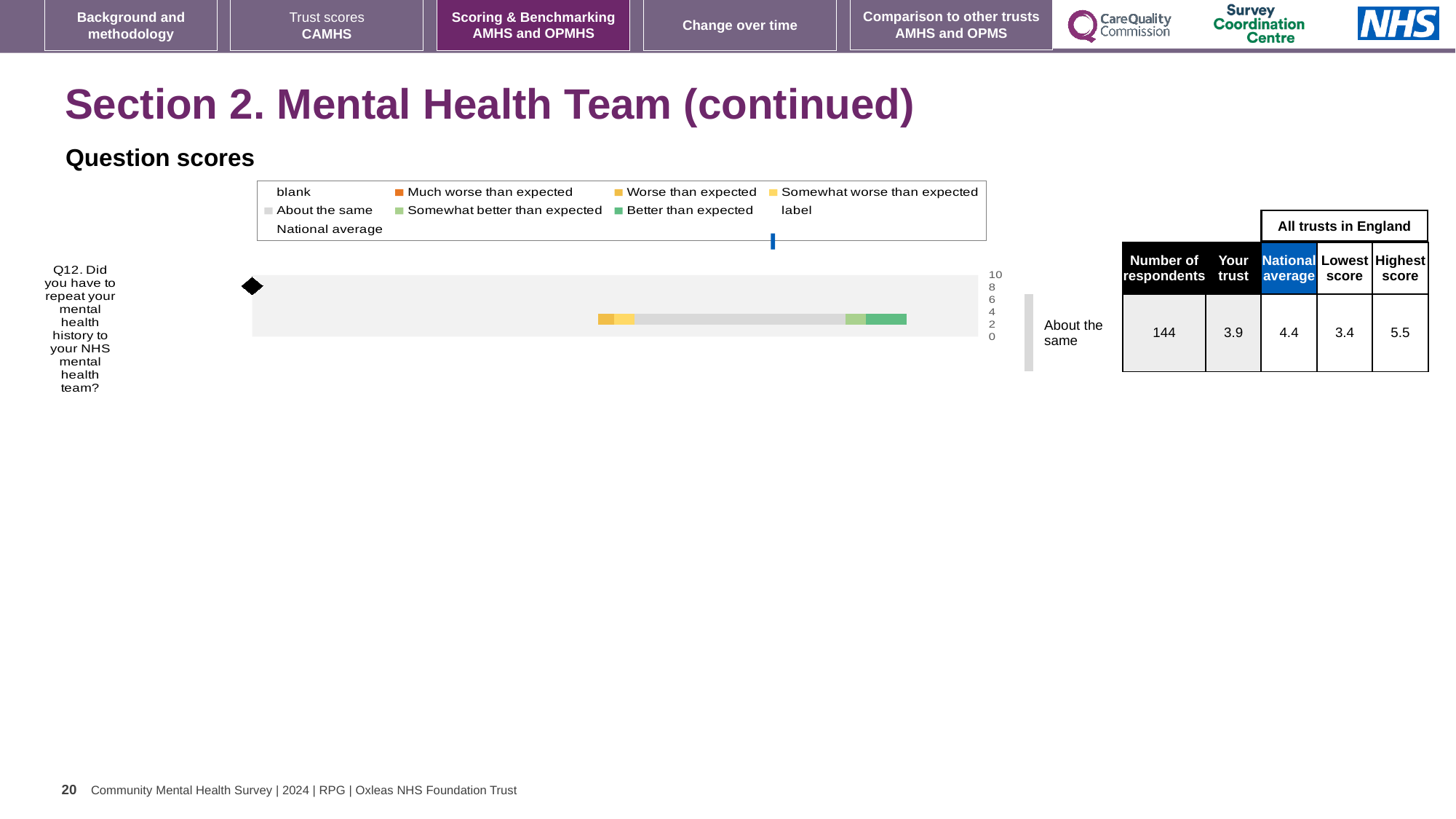
Which is larger for Q12, the 'Your trust' score or the national average? National average What is the difference between the highest score and the lowest score for Q12? 2.1 What is the highest score among all trusts in England for Q12? 5.5 Which benchmark category is Q12 placed in, according to the label next to the chart? About the same What is the difference between the national average and the 'Your trust' score for Q12? 0.5 What is the heading shown above the chart? Question scores How many respondents answered Q12? 144 What is the national average score for Q12? 4.4 What kind of chart is used to show the Q12 question score? bar chart What is the 'Your trust' score for Q12? 3.9 What is the lowest score among all trusts in England for Q12? 3.4 How many survey questions are plotted on the chart? 1